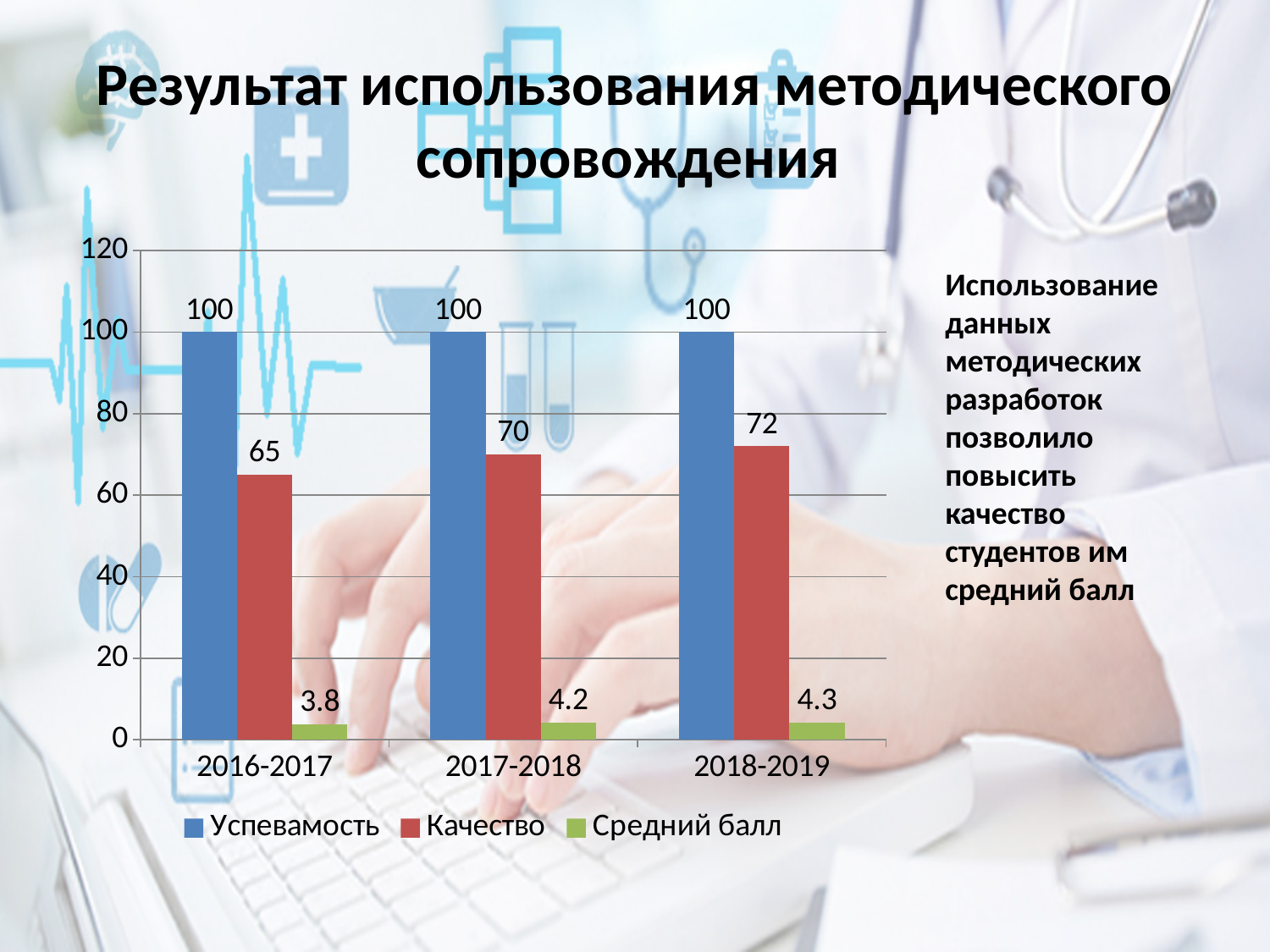
How many series does the legend list? 3 In which period is Качество the highest? 2018-2019 Does Средний балл rise or fall from 2016-2017 to 2018-2019? rise How many periods are shown on the x axis? 3 What is the difference between Качество in 2018-2019 and in 2016-2017? 7 What is the value of Качество for 2016-2017? 65 What kind of chart is shown on the slide? bar chart In which period is Средний балл the lowest? 2016-2017 What is the value of Средний балл for 2018-2019? 4.3 Is the value of Качество for 2017-2018 greater or less than 80? less What is the value of Успеваемость for 2017-2018? 100 Which is larger: Качество in 2017-2018 or Качество in 2016-2017? 2017-2018